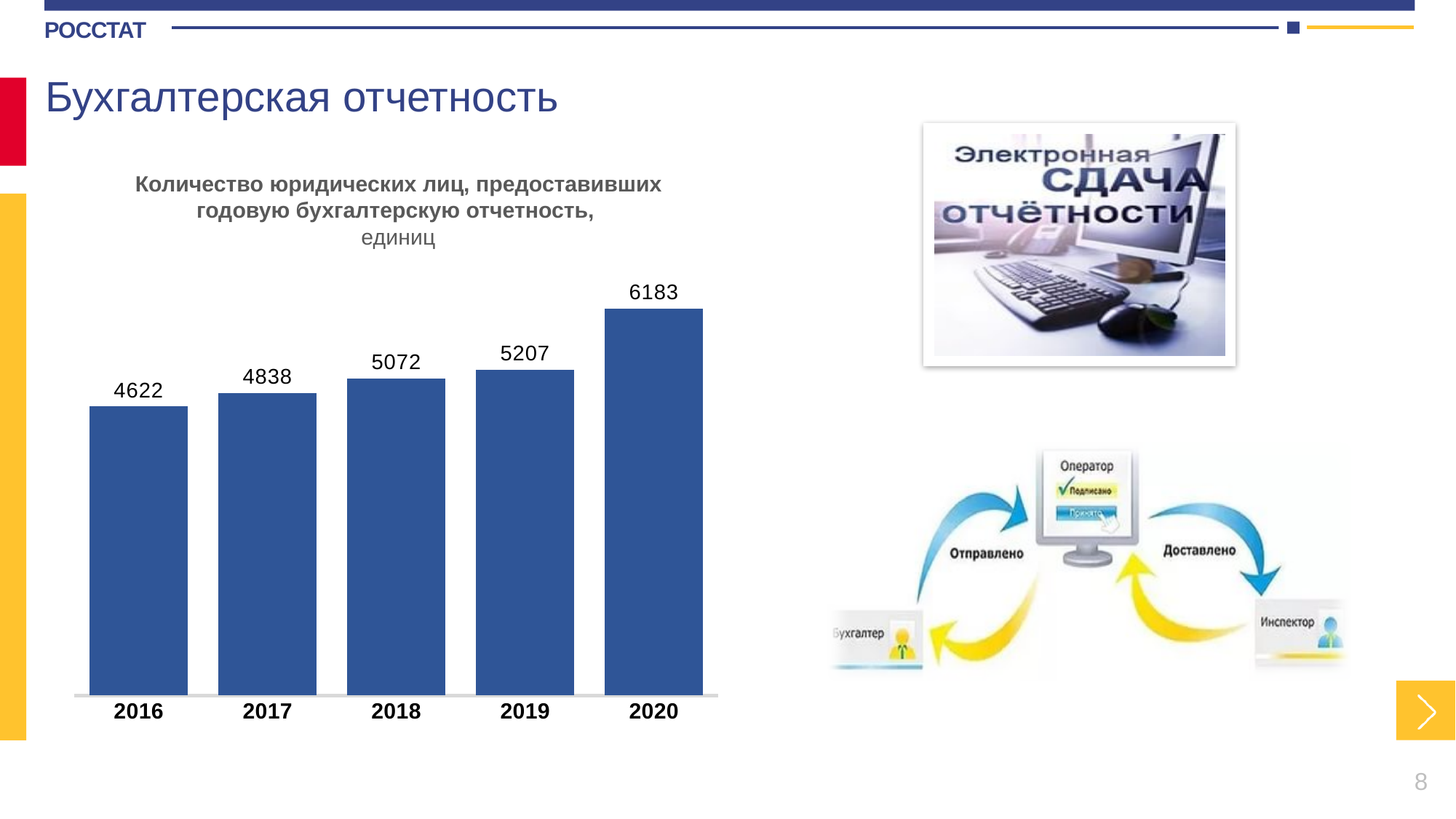
What is the difference between the values for 2020 and 2019? 976 Which is larger, the value for 2018 or the value for 2017? 2018 What is the value for 2018? 5072 How many years are shown on the chart? 5 What is the value for 2020? 6183 Do the values rise or fall from 2016 to 2020? rise Which year has the lowest value? 2016 What unit is stated in the chart title? единиц What is the value for 2016? 4622 Which year has the highest value? 2020 What kind of chart is shown on the slide? bar chart What is the difference between the values for 2017 and 2016? 216